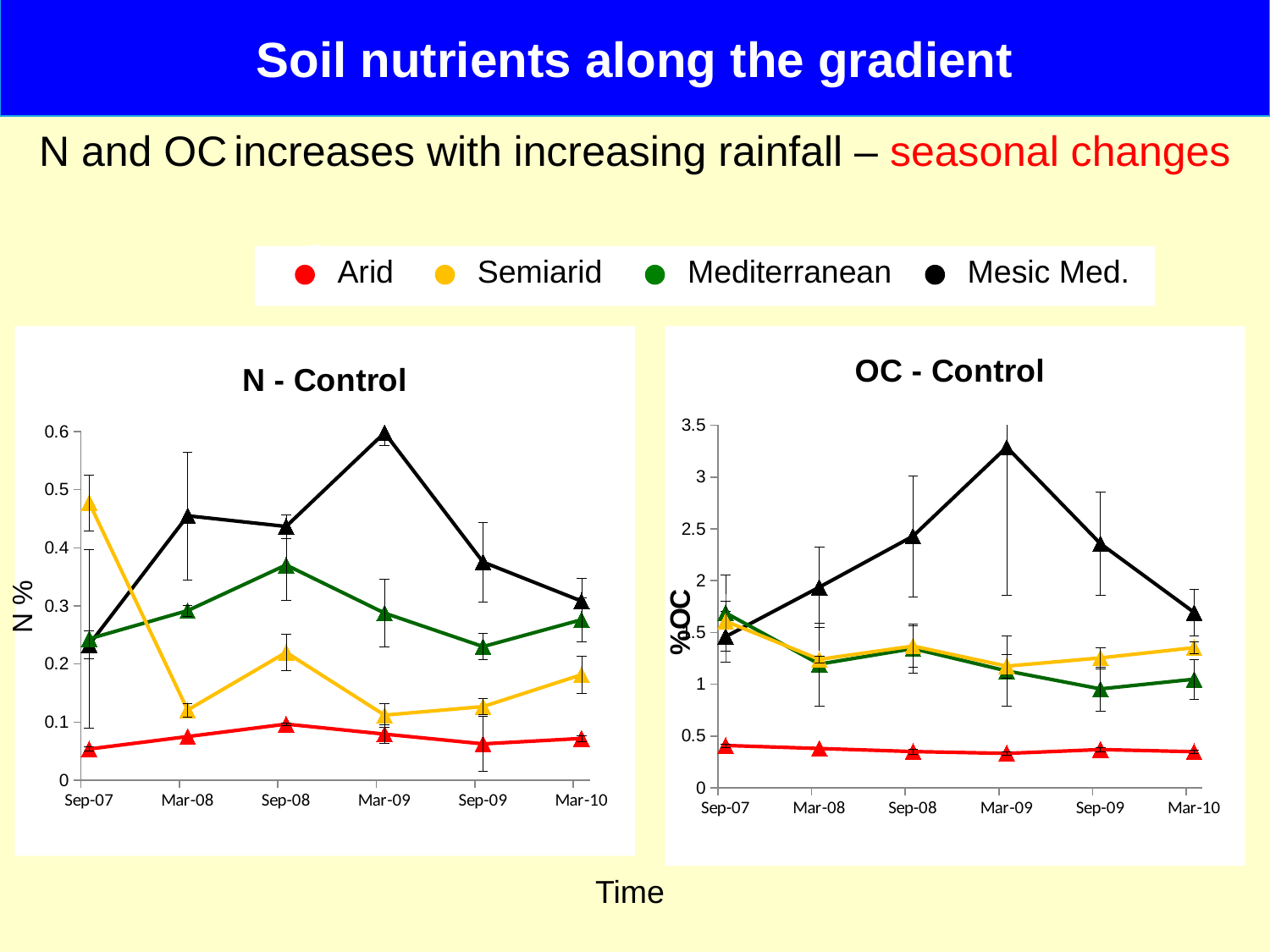
How many series does the legend list? 4 In the N - Control chart, at which time point does the Mesic Med. series reach its highest value? Mar-09 How many time points are plotted on the x axis of the OC - Control chart? 6 What kind of chart is the N - Control chart? line chart In the N - Control chart, does the Semiarid series rise or fall from Sep-07 to Mar-08? fall In the OC - Control chart, is the value for Mesic Med. at Mar-09 greater or less than 3? greater In the N - Control chart, is the value for Semiarid at Sep-07 greater or less than 0.4? greater In the N - Control chart, which is larger at Mar-09: Mesic Med. or Mediterranean? Mesic Med. In the OC - Control chart, which series has the lowest values across all time points? Arid In the OC - Control chart, which is larger at Mar-10: Semiarid or Mediterranean? Semiarid In the OC - Control chart, is the value for Arid at Mar-09 greater or less than 0.5? less What is the y-axis label of the N - Control chart? N %